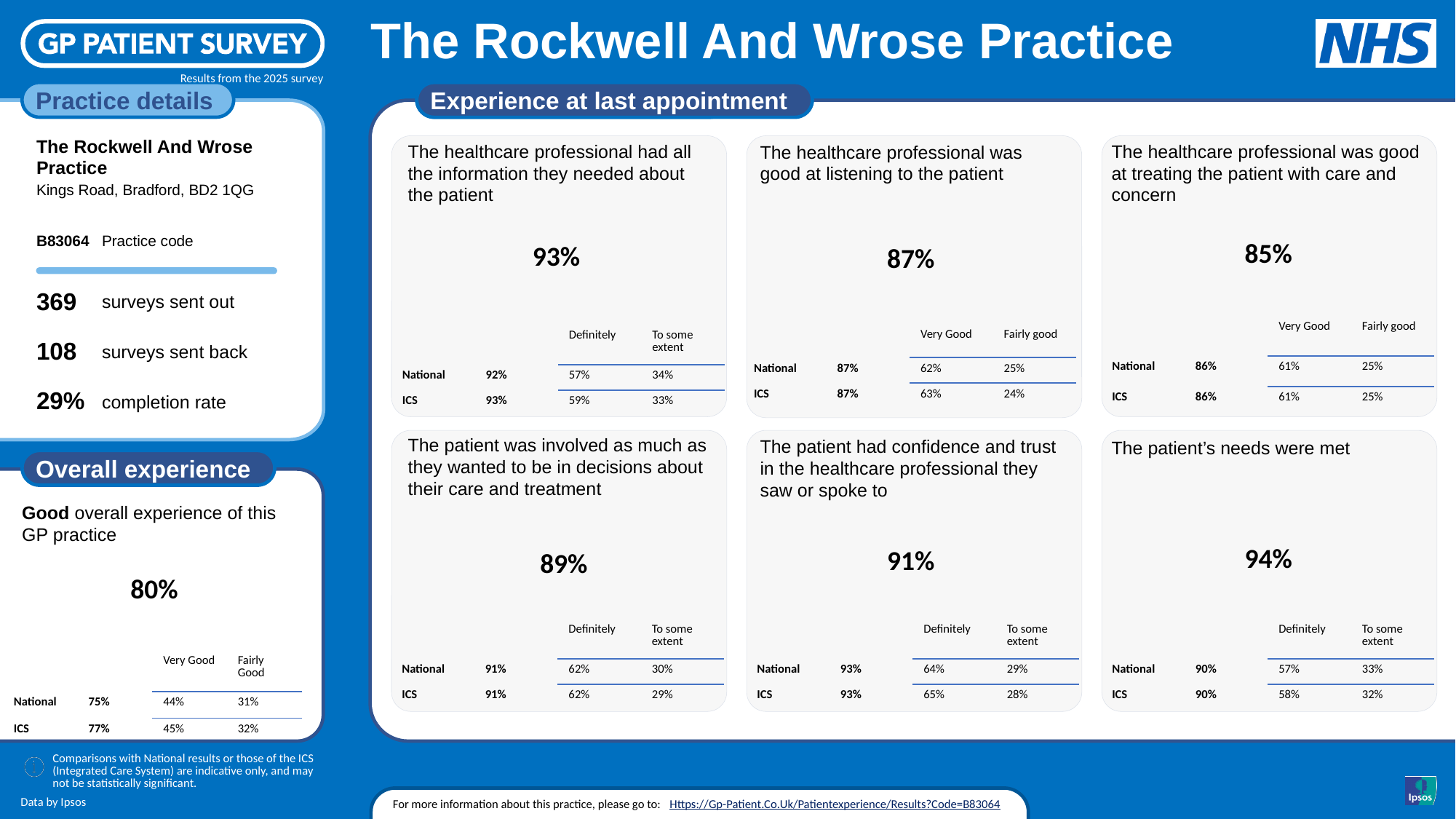
In the panel 'The healthcare professional was good at listening to the patient', what is the National 'Very Good' value? 62% In the 'Experience at last appointment' section, what is the practice value for 'The patient's needs were met'? 94% In the 'Experience at last appointment' section, which of the six measures has the highest practice value? The patient's needs were met In the 'Overall experience' panel, what is the ICS 'Very Good' value? 45% In the 'Practice details' panel, what is the completion rate? 29% In the 'Experience at last appointment' section, what is the practice value for 'The healthcare professional had all the information they needed about the patient'? 93% In the 'Experience at last appointment' section, is the practice value for 'The patient had confidence and trust in the healthcare professional they saw or spoke to' larger or smaller than the practice value for 'The patient was involved as much as they wanted to be in decisions about their care and treatment'? larger In the 'Experience at last appointment' section, how many measures are shown? 6 In the 'Overall experience' panel, what is the National value for good overall experience? 75% In the 'Overall experience' panel, what percentage of patients reported a good overall experience of this GP practice? 80% In the 'Overall experience' panel, what is the difference between the practice value (80%) and the National value (75%)? 5% In the 'Experience at last appointment' section, which of the six measures has the lowest practice value? The healthcare professional was good at treating the patient with care and concern